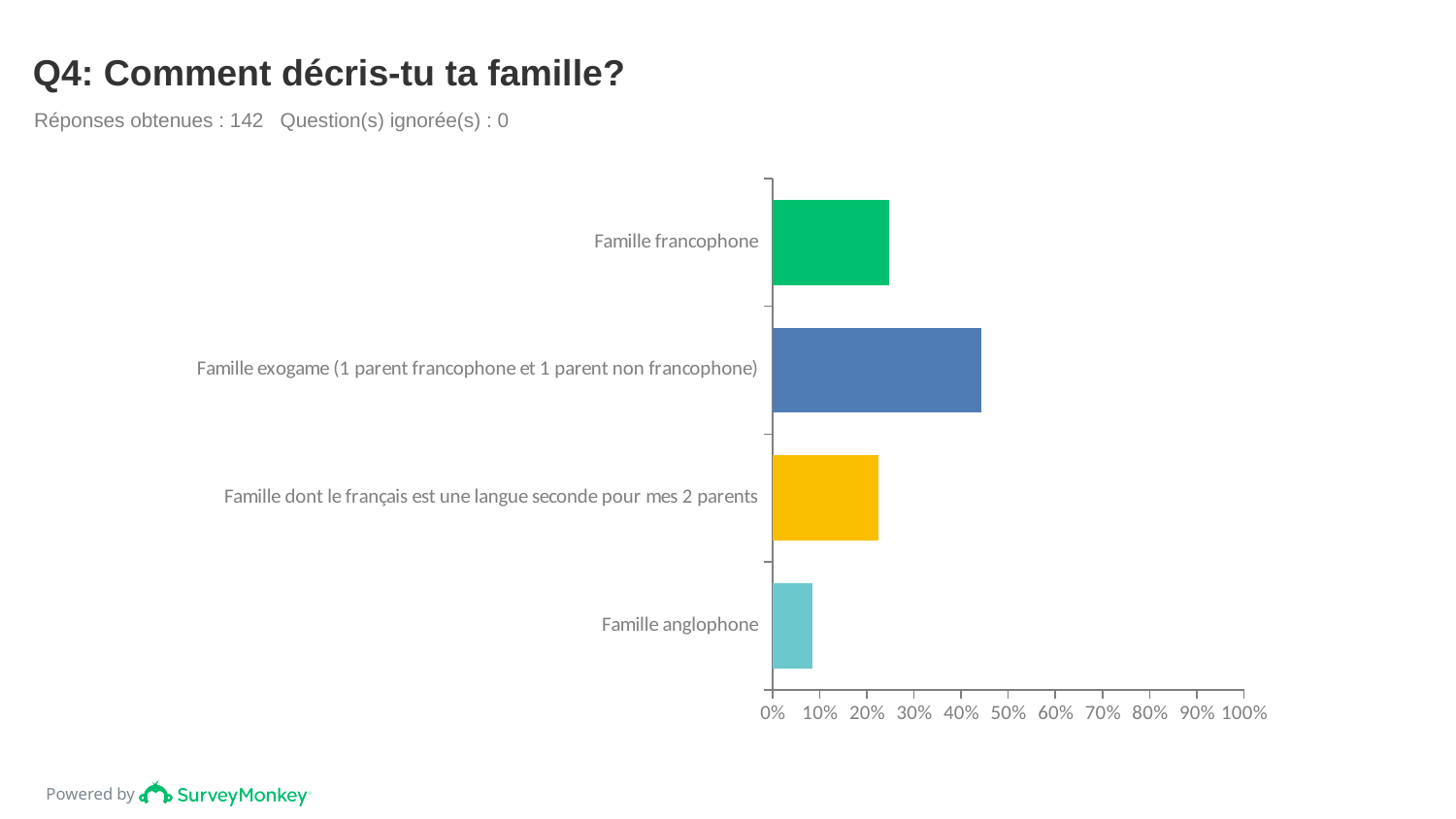
Which category has the lowest value? Famille anglophone Which is larger: the value for Famille francophone or the value for Famille anglophone? Famille francophone What is the title of the chart? Q4: Comment décris-tu ta famille? Is the value for Famille francophone greater or less than 20%? greater Is the value for Famille dont le français est une langue seconde pour mes 2 parents greater or less than 30%? less Which category has the highest value? Famille exogame (1 parent francophone et 1 parent non francophone) Is the value for Famille exogame (1 parent francophone et 1 parent non francophone) greater or less than 40%? greater How many categories are shown in the chart? 4 Which is larger: the value for Famille exogame (1 parent francophone et 1 parent non francophone) or the value for Famille francophone? Famille exogame (1 parent francophone et 1 parent non francophone) What is the maximum value shown on the x axis? 100% What kind of chart is shown on the slide? bar chart